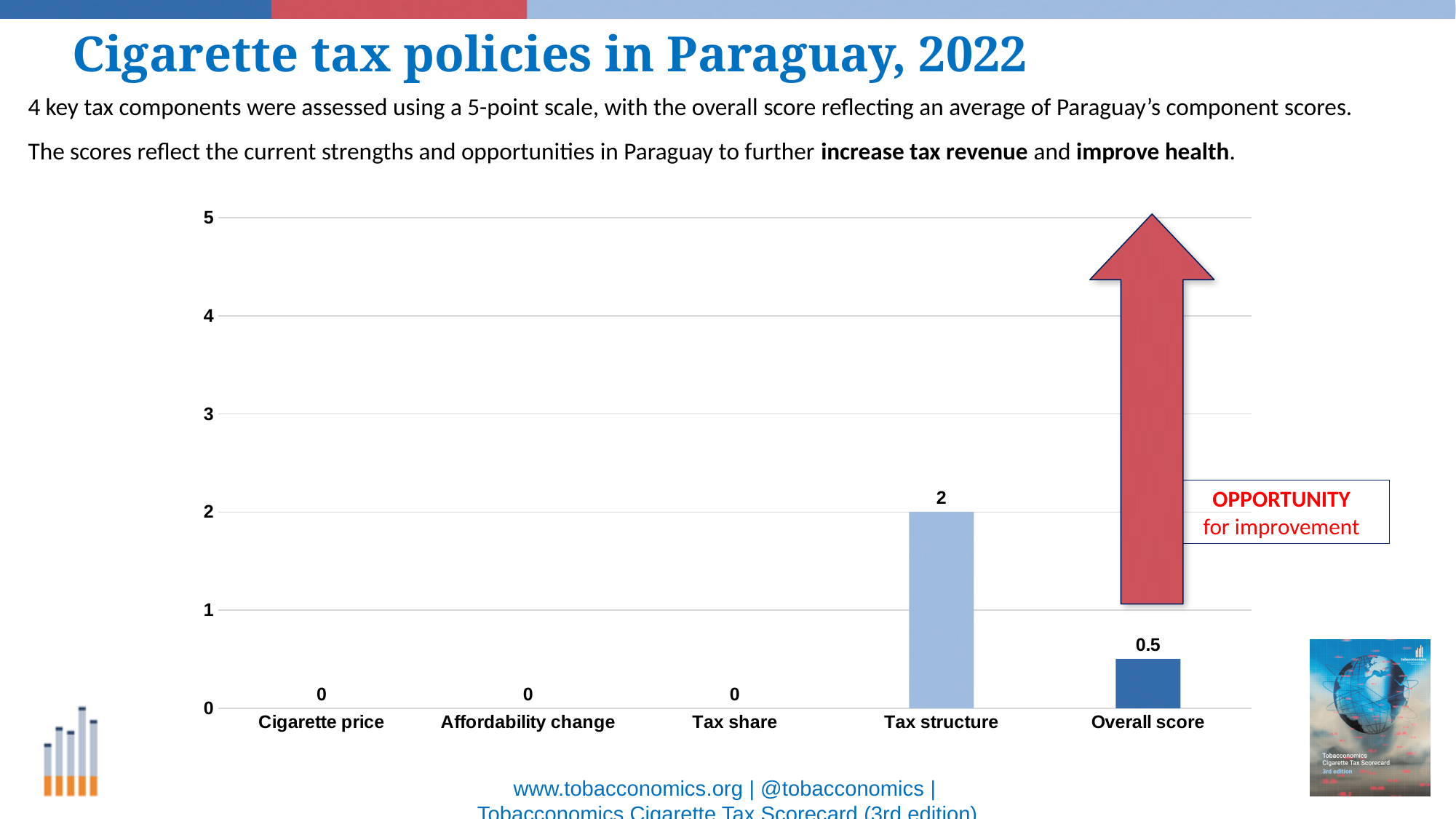
How many categories have a value of 0? 3 What kind of chart is shown on the slide? bar chart Is the value for Tax structure greater or less than 3? less How many categories are shown on the x axis? 5 What is the value for Tax structure? 2 What is the maximum value shown on the y axis? 5 Which is larger, the value for Tax structure or the value for Overall score? Tax structure Which category has the highest value? Tax structure What is the value for Tax share? 0 What is the value for Overall score? 0.5 What is the difference between the values for Tax structure and Overall score? 1.5 What is the value for Cigarette price? 0